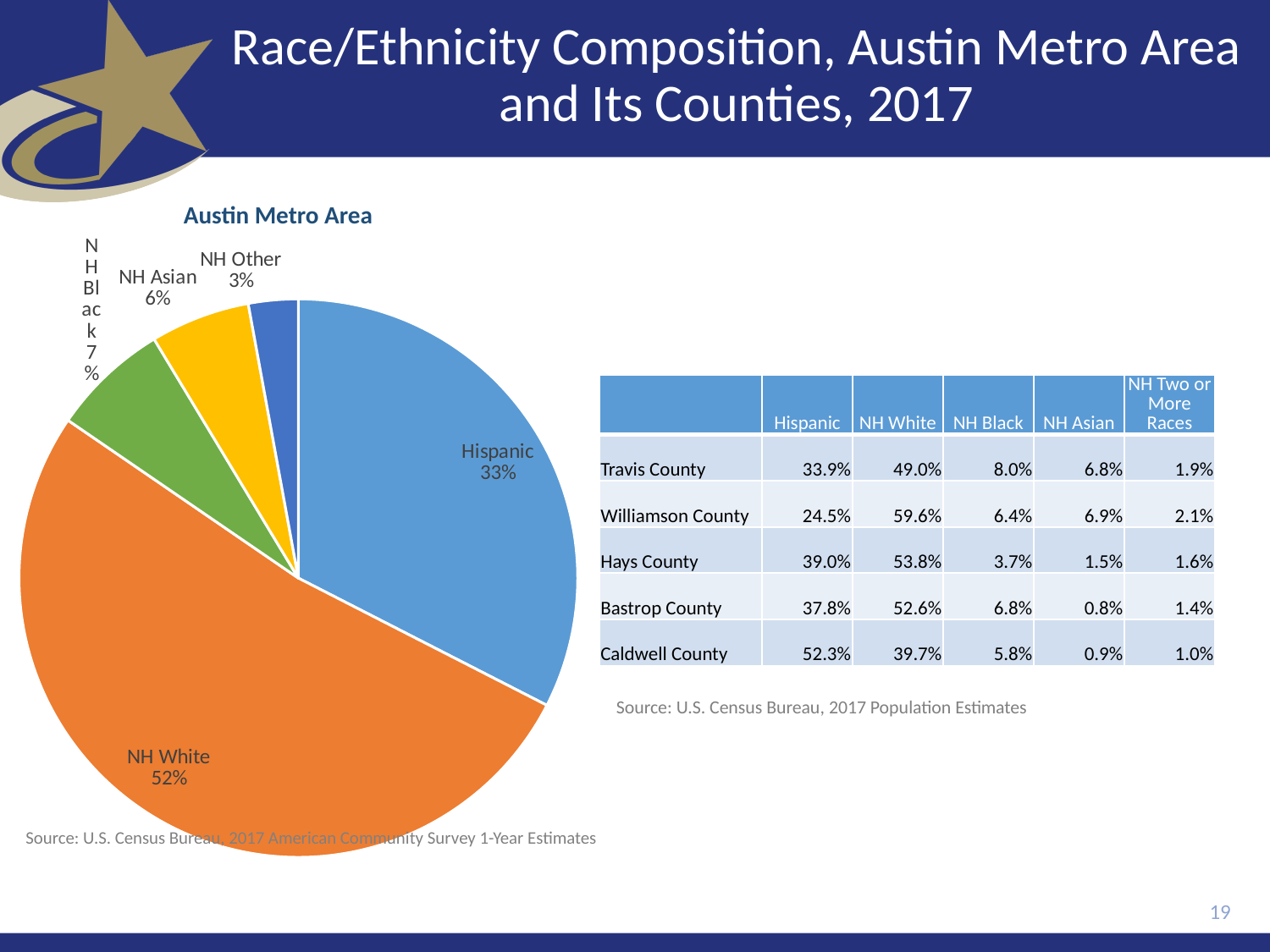
What is the title of the pie chart on the slide? Austin Metro Area What share of the Austin Metro Area pie is Hispanic? 33% Which slice of the Austin Metro Area pie chart is the smallest? NH Other How many slices does the Austin Metro Area pie chart have? 5 In the Austin Metro Area pie chart, what is the difference between the NH White share and the Hispanic share? 19% Which slice of the Austin Metro Area pie chart is the largest? NH White In the Austin Metro Area pie chart, which is larger, the NH Black share or the NH Asian share? NH Black What kind of chart is the Austin Metro Area chart? pie chart What share of the Austin Metro Area pie is NH White? 52% What share of the Austin Metro Area pie is NH Black? 7%